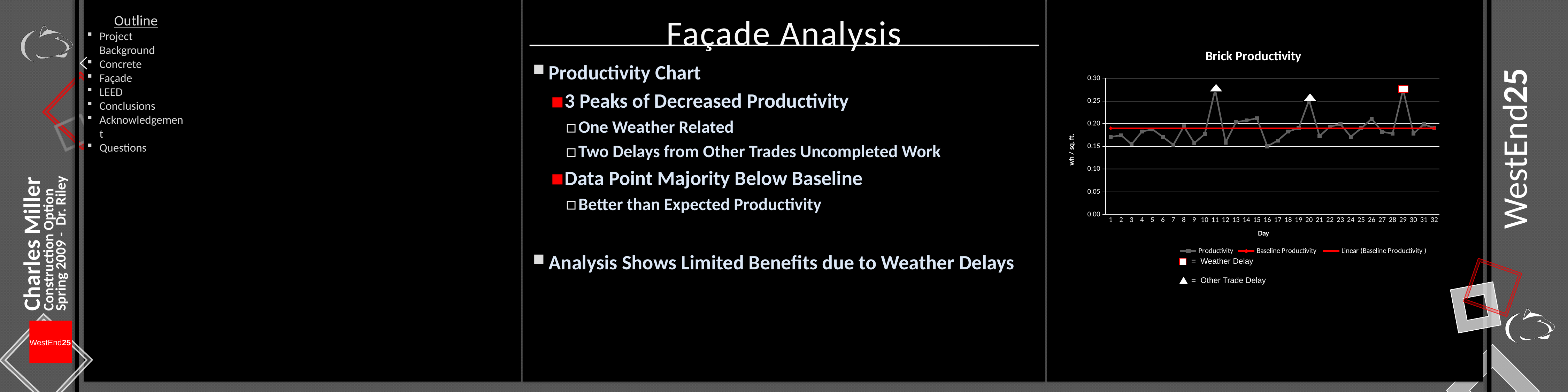
Which is larger on the Brick Productivity chart, the Productivity value for Day 11 or the Productivity value for Day 16? Day 11 Is the Productivity value for Day 1 greater or less than 0.20? less What is the label of the y axis on the Brick Productivity chart? wh / sq. ft. Is the Productivity value for Day 11 greater or less than 0.25? greater Is the Productivity value for Day 29 greater or less than 0.25? greater How many series does the legend of the Brick Productivity chart list? 3 Which is larger on the Brick Productivity chart, the Productivity value for Day 29 or the Productivity value for Day 30? Day 29 How many days are plotted along the x axis of the Brick Productivity chart? 32 What is the title of the chart on the slide? Brick Productivity What kind of chart is the Brick Productivity chart? line chart